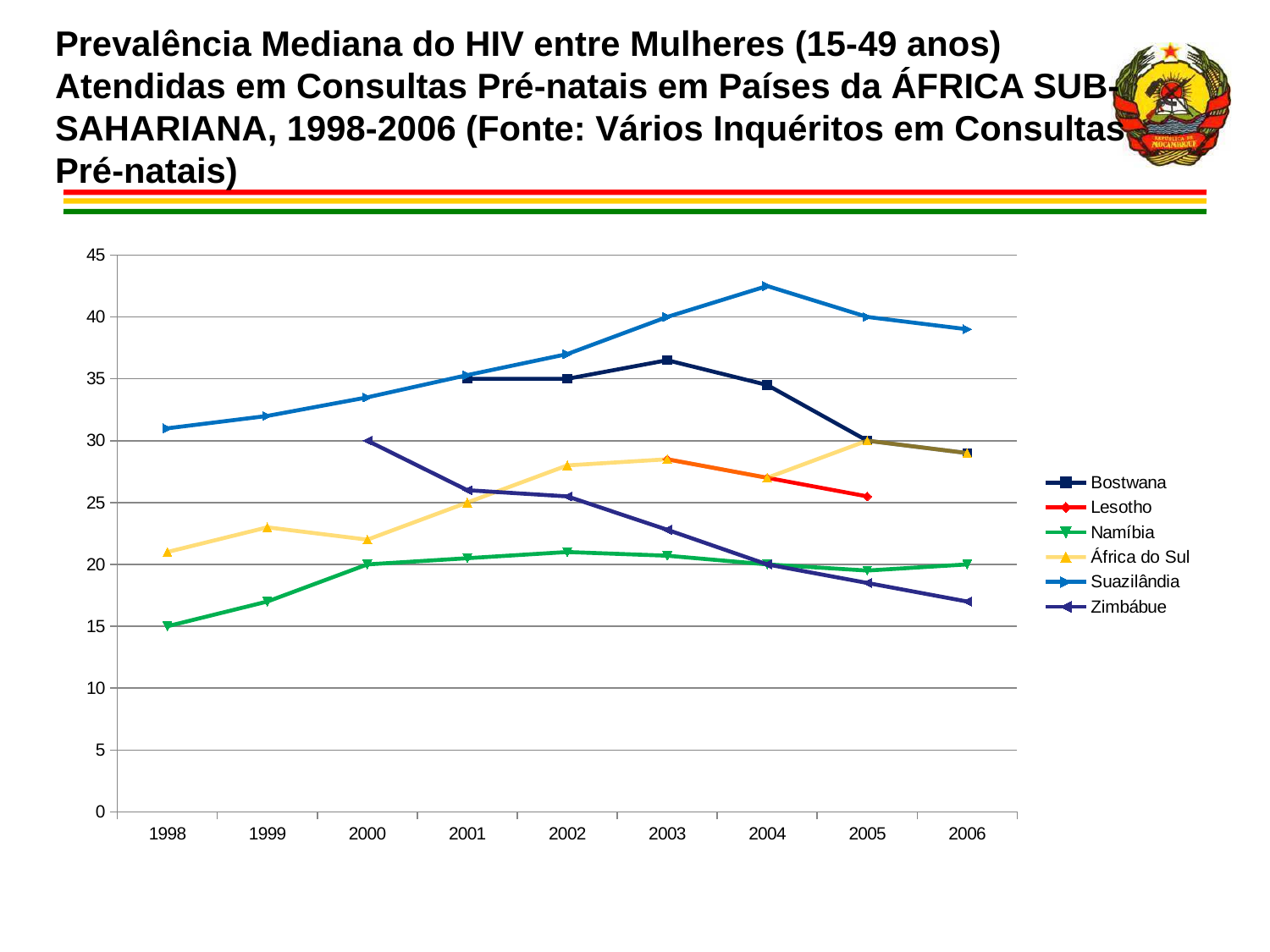
What is the value for Namíbia in 1998? 15 What is the value for Suazilândia in 2005? 40 What kind of chart is shown on the slide? line chart Is the value for Suazilândia in 2004 greater or less than 40? greater Does the value for Zimbábue rise or fall from 2000 to 2006? fall In 2003, which is larger: the value for Bostwana or the value for Suazilândia? Suazilândia Is the value for Zimbábue in 2006 greater or less than 20? less How many years are shown on the x axis? 9 Which country has the lowest value in 2006? Zimbábue What is the value for Zimbábue in 2000? 30 Which country has the highest value in 2004? Suazilândia How many series does the legend list? 6